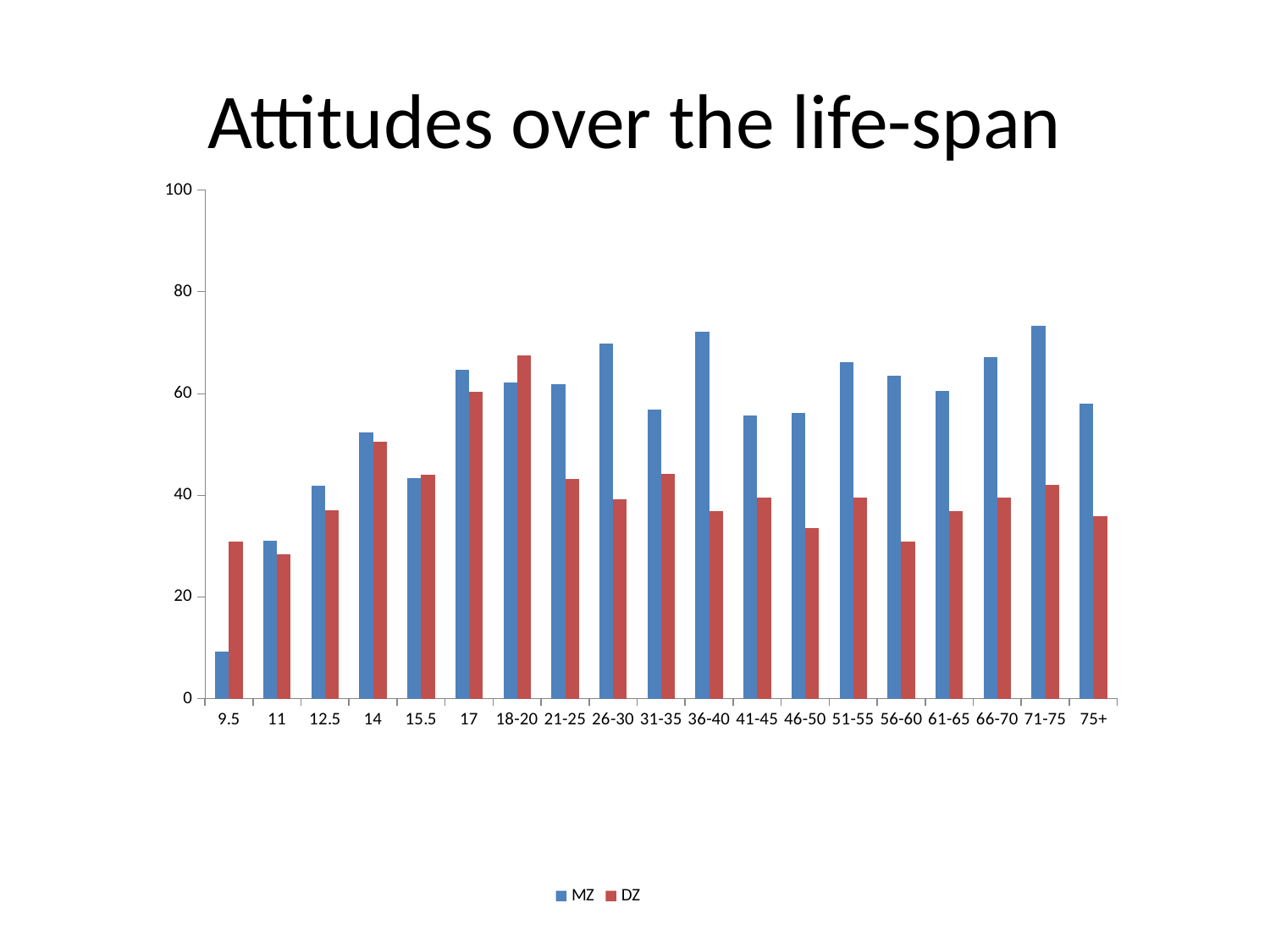
Is the MZ value for 36-40 greater or less than 60? greater Is the DZ value for 46-50 greater or less than 40? less What kind of chart is shown on the slide? bar chart How many age categories are shown on the x axis? 19 What is the title of the chart? Attitudes over the life-span For the 36-40 category, which series has the larger value, MZ or DZ? MZ Is the DZ value for 18-20 greater or less than 60? greater How many series does the legend list? 2 For the 9.5 category, which series has the larger value, MZ or DZ? DZ Which age category has the highest DZ value? 18-20 Which age category has the lowest MZ value? 9.5